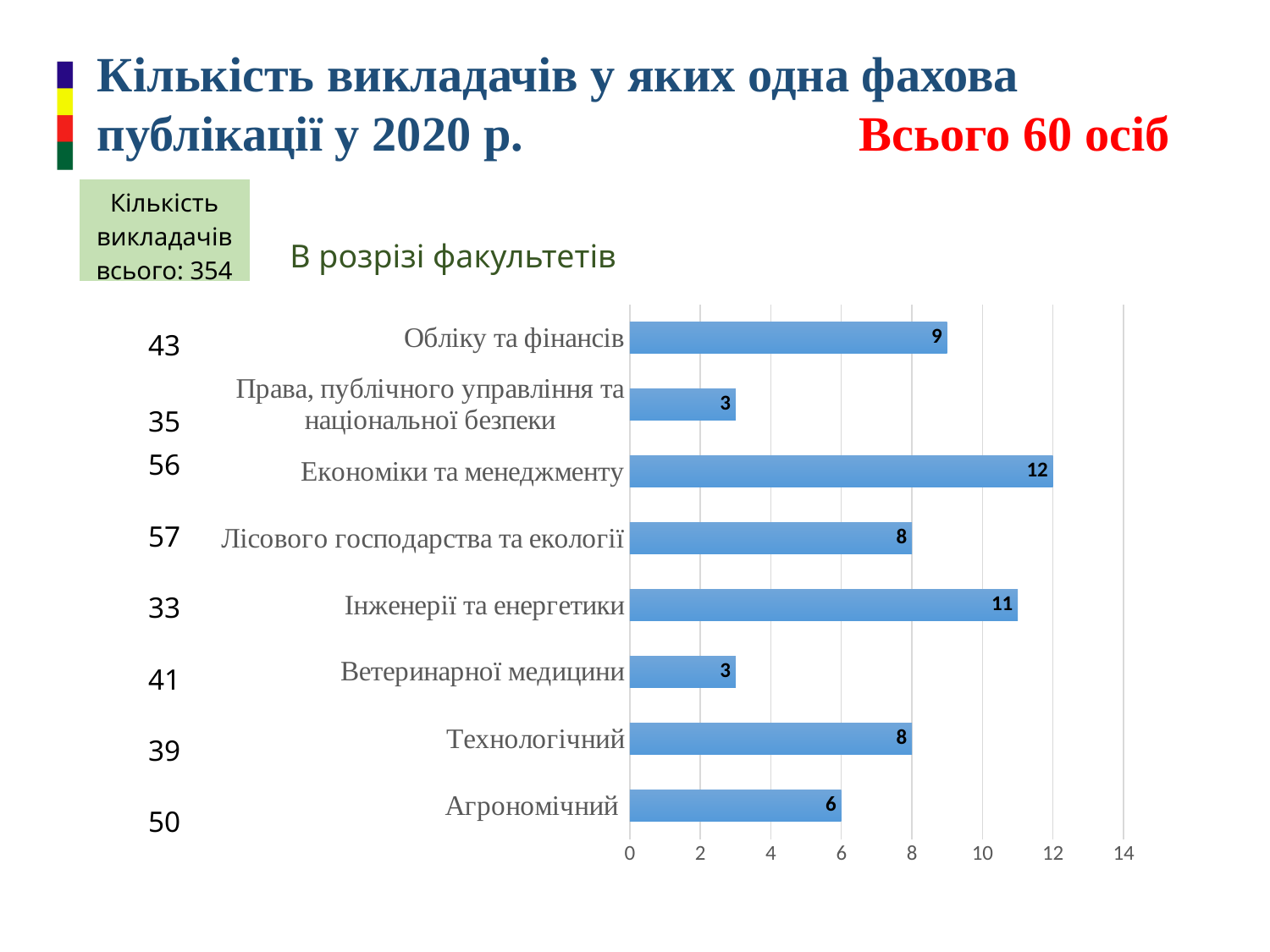
What is the value for Інженерії та енергетики? 11 How many faculties are shown in the chart? 8 Is the value for Лісового господарства та екології greater or less than 10? less Which is larger, the value for Обліку та фінансів or the value for Технологічний? Обліку та фінансів What is the value for Права, публічного управління та національної безпеки? 3 What kind of chart is shown on the slide? bar chart What is the difference between the values for Інженерії та енергетики and Ветеринарної медицини? 8 What is the total number of people stated in the slide title? 60 осіб What is the value for Економіки та менеджменту? 12 What is the difference between the values for Економіки та менеджменту and Обліку та фінансів? 3 Which faculty has the highest value? Економіки та менеджменту What is the value for Агрономічний? 6